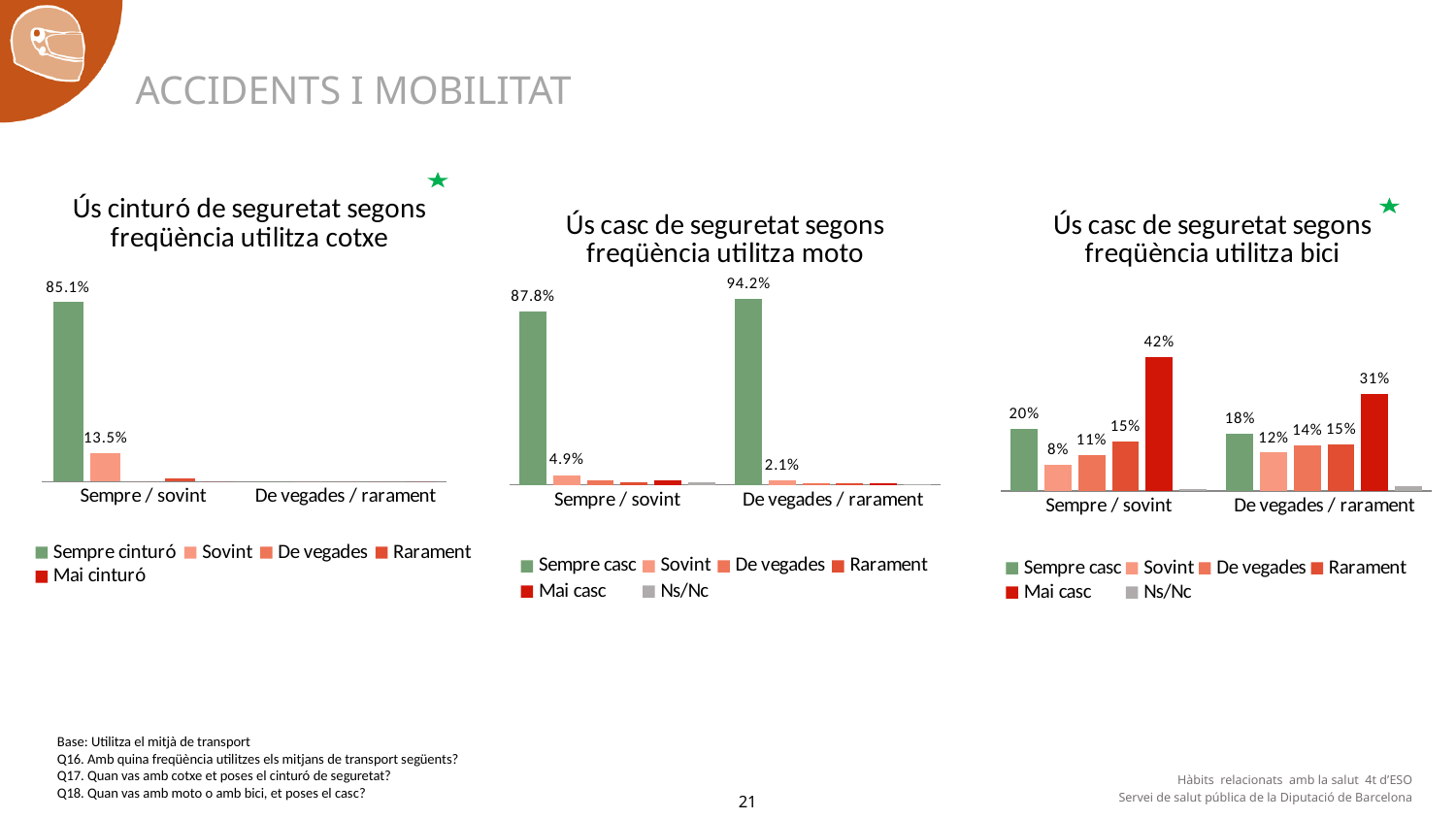
In the chart 'Ús cinturó de seguretat segons freqüència utilitza cotxe', what is the value of 'Sempre cinturó' for the 'Sempre / sovint' category? 85.1% In the chart 'Ús casc de seguretat segons freqüència utilitza bici', which series has the highest value in the 'Sempre / sovint' category? Mai casc In the chart 'Ús casc de seguretat segons freqüència utilitza bici', what is the value of 'Mai casc' for the 'Sempre / sovint' category? 42% How many series does the legend of the chart 'Ús casc de seguretat segons freqüència utilitza bici' list? 6 What kind of chart is the middle chart, 'Ús casc de seguretat segons freqüència utilitza moto'? Bar chart In the chart 'Ús casc de seguretat segons freqüència utilitza moto', what is the value of 'Sempre casc' for the 'De vegades / rarament' category? 94.2% In the chart 'Ús casc de seguretat segons freqüència utilitza moto', what is the difference between the 'Sempre casc' values for 'De vegades / rarament' and 'Sempre / sovint'? 6.4 percentage points In the chart 'Ús casc de seguretat segons freqüència utilitza bici', is the 'Mai casc' value larger for 'Sempre / sovint' or for 'De vegades / rarament'? Sempre / sovint In the chart 'Ús cinturó de seguretat segons freqüència utilitza cotxe', what is the value of 'Sovint' for the 'Sempre / sovint' category? 13.5% In the chart 'Ús casc de seguretat segons freqüència utilitza bici', what is the difference between the 'Mai casc' values for 'Sempre / sovint' and 'De vegades / rarament'? 11 percentage points In the chart 'Ús casc de seguretat segons freqüència utilitza bici', what is the value of 'Sovint' for the 'De vegades / rarament' category? 12% How many series does the legend of the chart 'Ús cinturó de seguretat segons freqüència utilitza cotxe' list? 5